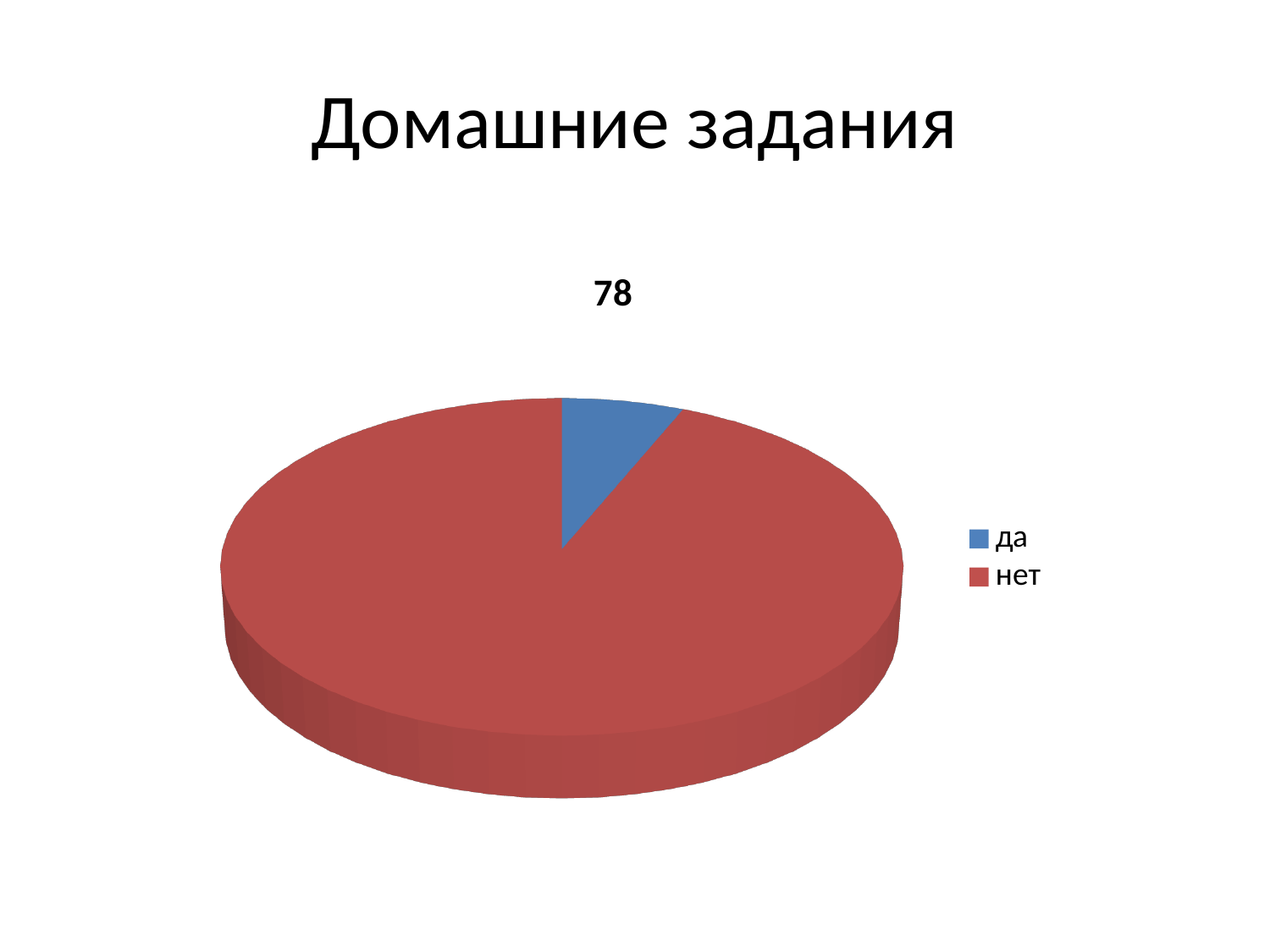
How many categories does the legend of the pie chart list? 2 What is the title shown above the pie chart? 78 Which category has the largest slice of the pie chart? нет What kind of chart is shown on the slide? pie chart Which category has the smallest slice of the pie chart? да Which slice is larger, да or нет? нет What colour is the slice for да in the pie chart? blue Does the slice for нет take up more or less than half of the pie? more